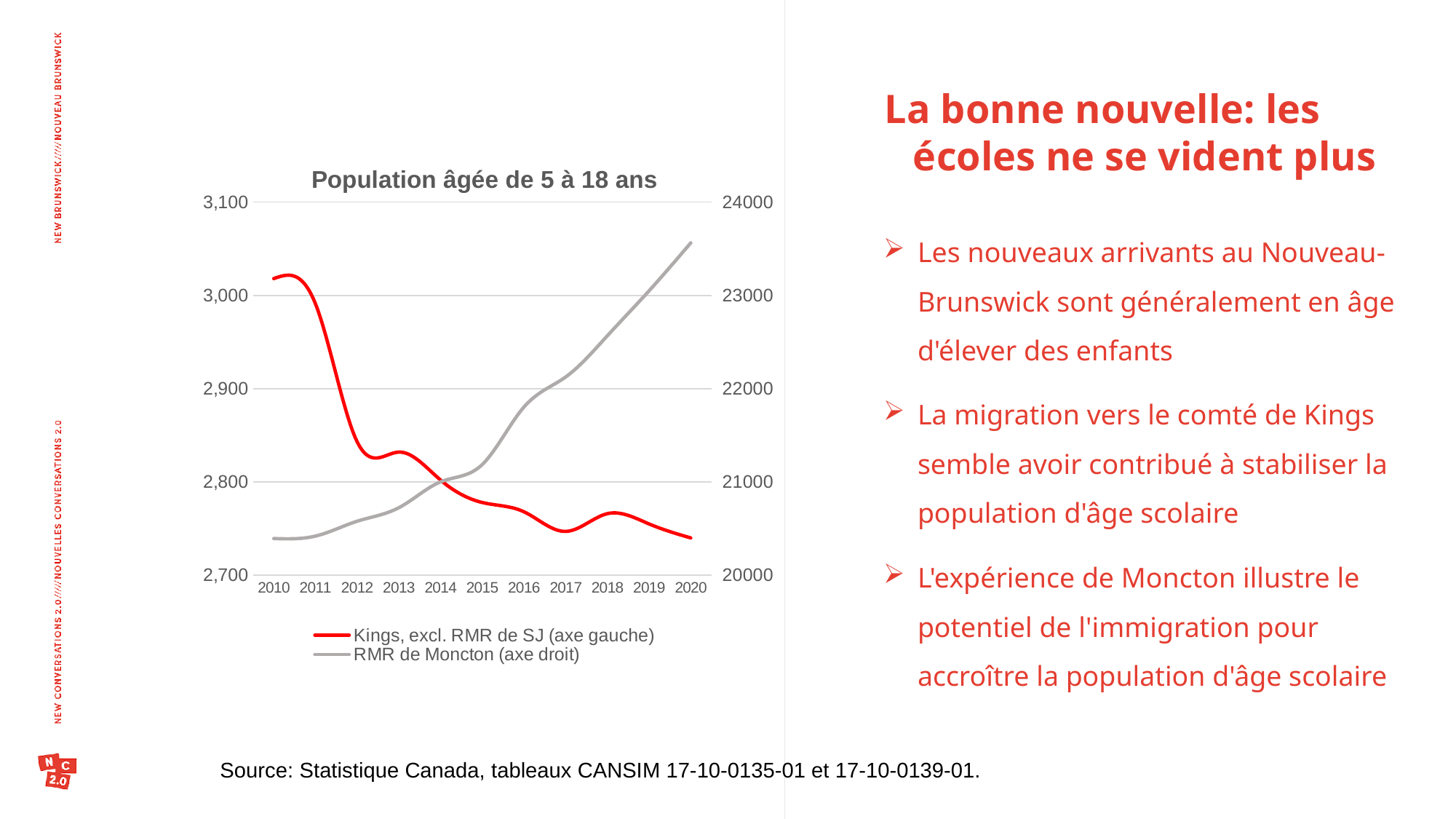
Is the value for Kings, excl. RMR de SJ in 2020 greater or less than 2,800? less Is the value for RMR de Moncton in 2010 greater or less than 21000? less What kind of chart is shown on the slide? line chart In which year is the RMR de Moncton series at its highest? 2020 How many years are plotted along the x axis? 11 What is the title of the chart? Population âgée de 5 à 18 ans Which series is plotted against the right-hand axis? RMR de Moncton (axe droit) Does the RMR de Moncton series rise or fall overall from 2010 to 2020? rise Does the Kings, excl. RMR de SJ series rise or fall overall from 2010 to 2020? fall In which year is the Kings, excl. RMR de SJ series at its highest? 2010 How many series does the legend list? 2 Is the value for RMR de Moncton in 2020 greater or less than 23000? greater